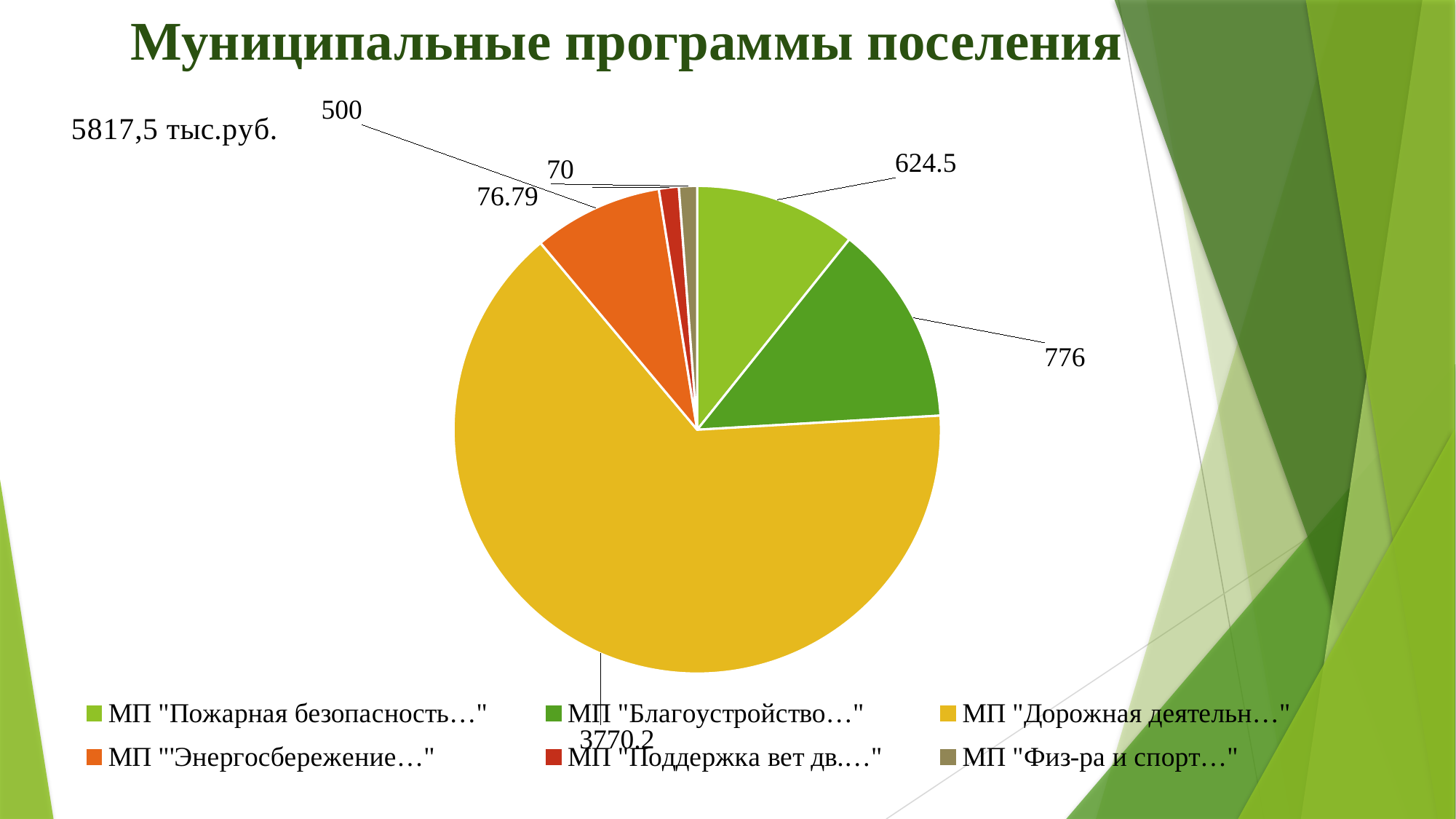
What kind of chart is shown on the slide? pie chart What is the difference between the values for МП "Благоустройство…" and МП "Пожарная безопасность…"? 151.5 How many slices does the pie chart have? 6 Which program has the largest slice of the pie? МП "Дорожная деятельн…" What is the value for МП "Поддержка вет дв.…"? 76.79 What is the value for МП "Пожарная безопасность…"? 624.5 Which is larger: the value for МП "Благоустройство…" or МП "Пожарная безопасность…"? МП "Благоустройство…" What is the difference between the values for МП "Пожарная безопасность…" and МП "'Энергосбережение…"? 124.5 What total amount is printed in the top-left corner of the slide? 5817,5 тыс.руб. What is the value for МП "Дорожная деятельн…"? 3770.2 Which program has the smallest slice of the pie? МП "Физ-ра и спорт…" What is the value for МП "Благоустройство…"? 776